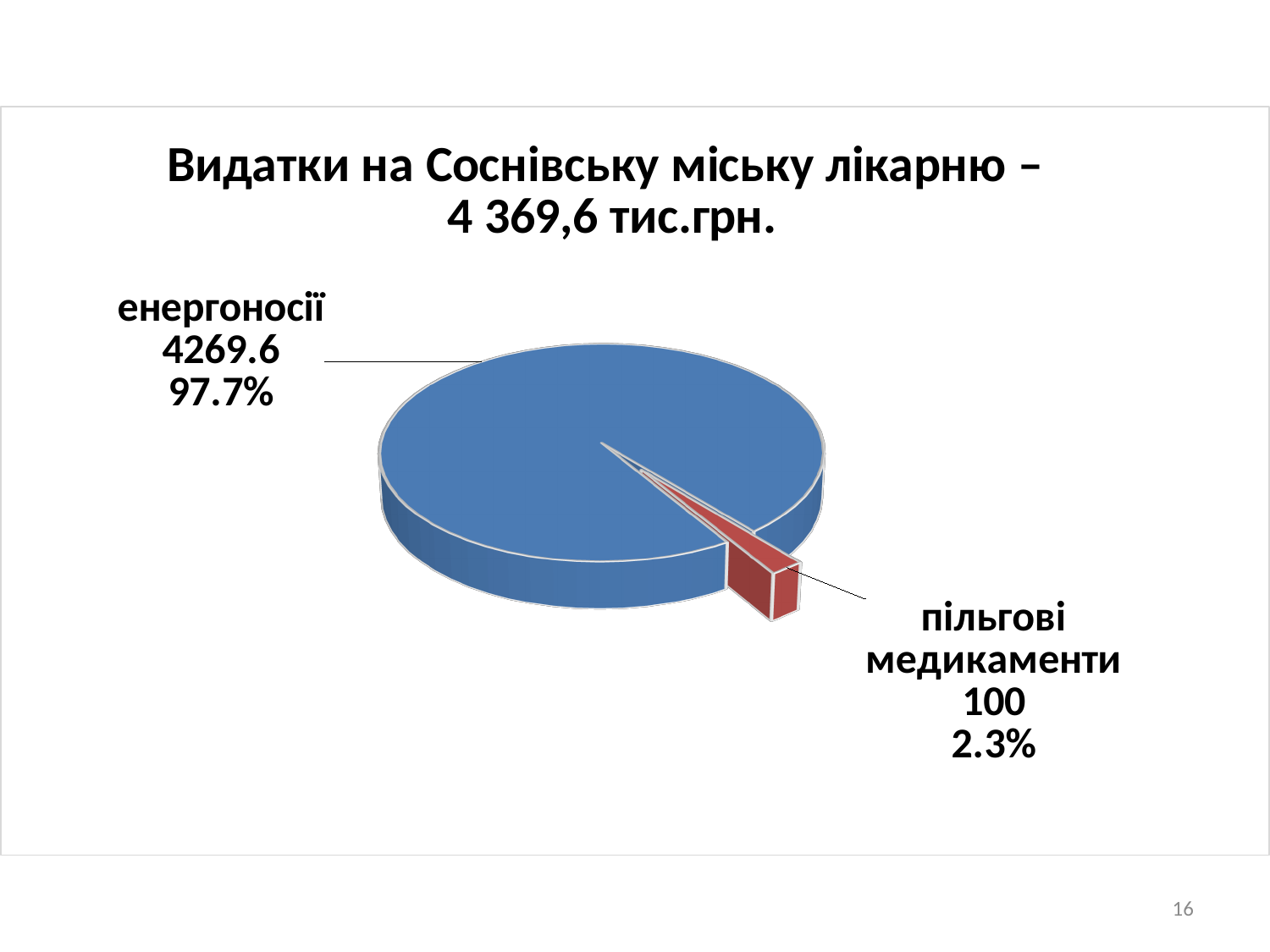
What colour is the slice for пільгові медикаменти? red What is the value for енергоносії? 4269.6 What is the value for пільгові медикаменти? 100 Which category has the smallest slice? пільгові медикаменти What share of the pie does пільгові медикаменти represent? 2.3% What is the difference between the values for енергоносії and пільгові медикаменти? 4169.6 How many slices does the pie chart have? 2 What share of the pie does енергоносії represent? 97.7% Which is larger, the value for енергоносії or the value for пільгові медикаменти? енергоносії What is the title of the chart? Видатки на Соснівську міську лікарню – 4 369,6 тис.грн. What kind of chart is shown on the slide? pie chart Which category has the largest slice? енергоносії